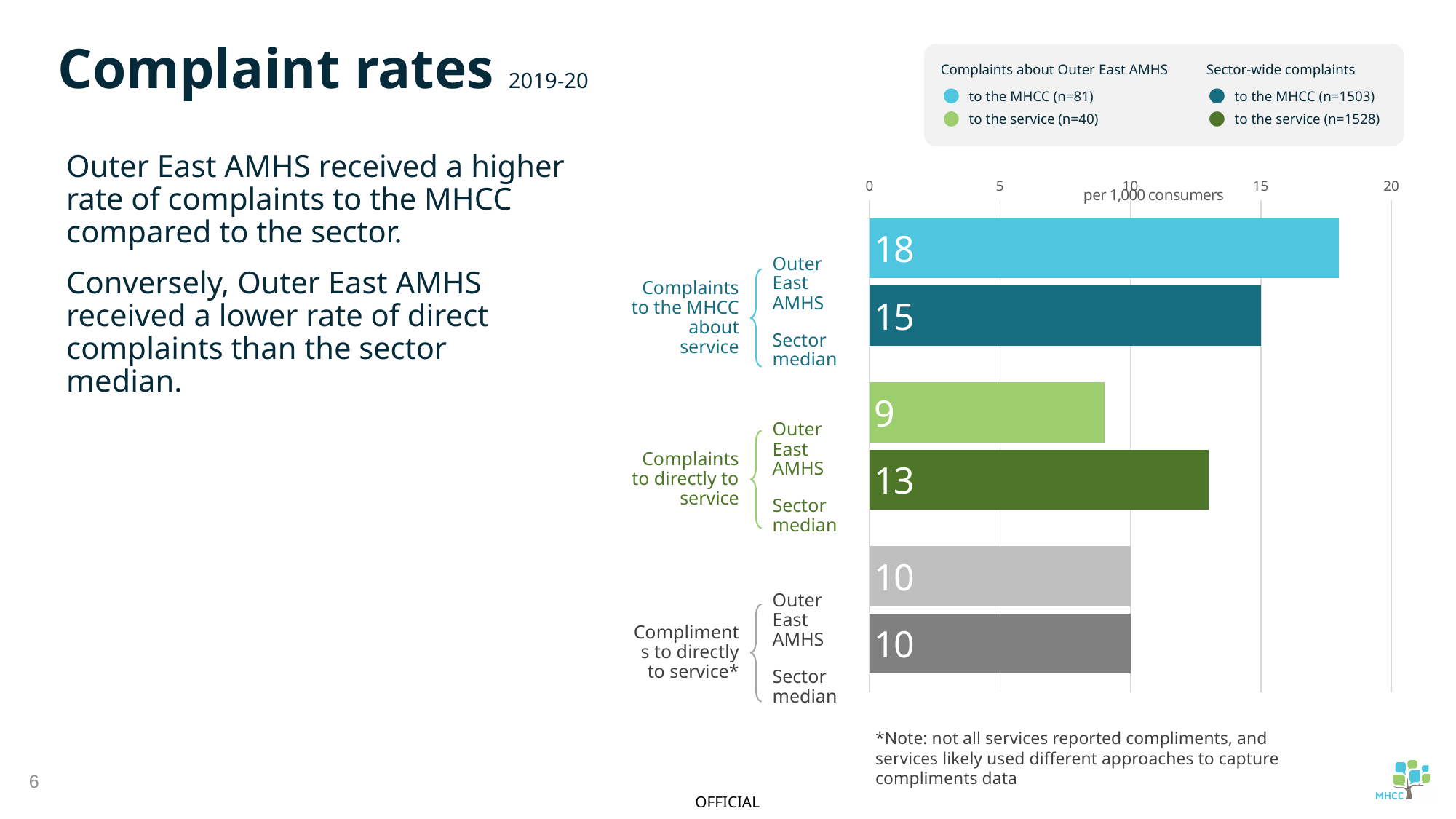
What is the rate of complaints directly to service for Outer East AMHS? 9 What is the rate of complaints to the MHCC about service for Outer East AMHS? 18 What is the sector median rate of complaints directly to service? 13 How many bars are plotted in the chart? 6 What is the difference between the Outer East AMHS rate and the sector median rate for complaints to the MHCC about service? 3 What is the difference between the sector median and the Outer East AMHS rate for complaints directly to service? 4 Which bar has the highest value in the chart? Complaints to the MHCC about service, Outer East AMHS What is the rate of compliments directly to service for Outer East AMHS? 10 What type of chart is shown on the slide? Bar chart Which bar has the lowest value in the chart? Complaints directly to service, Outer East AMHS What is the sector median rate of complaints to the MHCC about service? 15 For complaints directly to service, which is larger: the Outer East AMHS rate or the sector median? Sector median